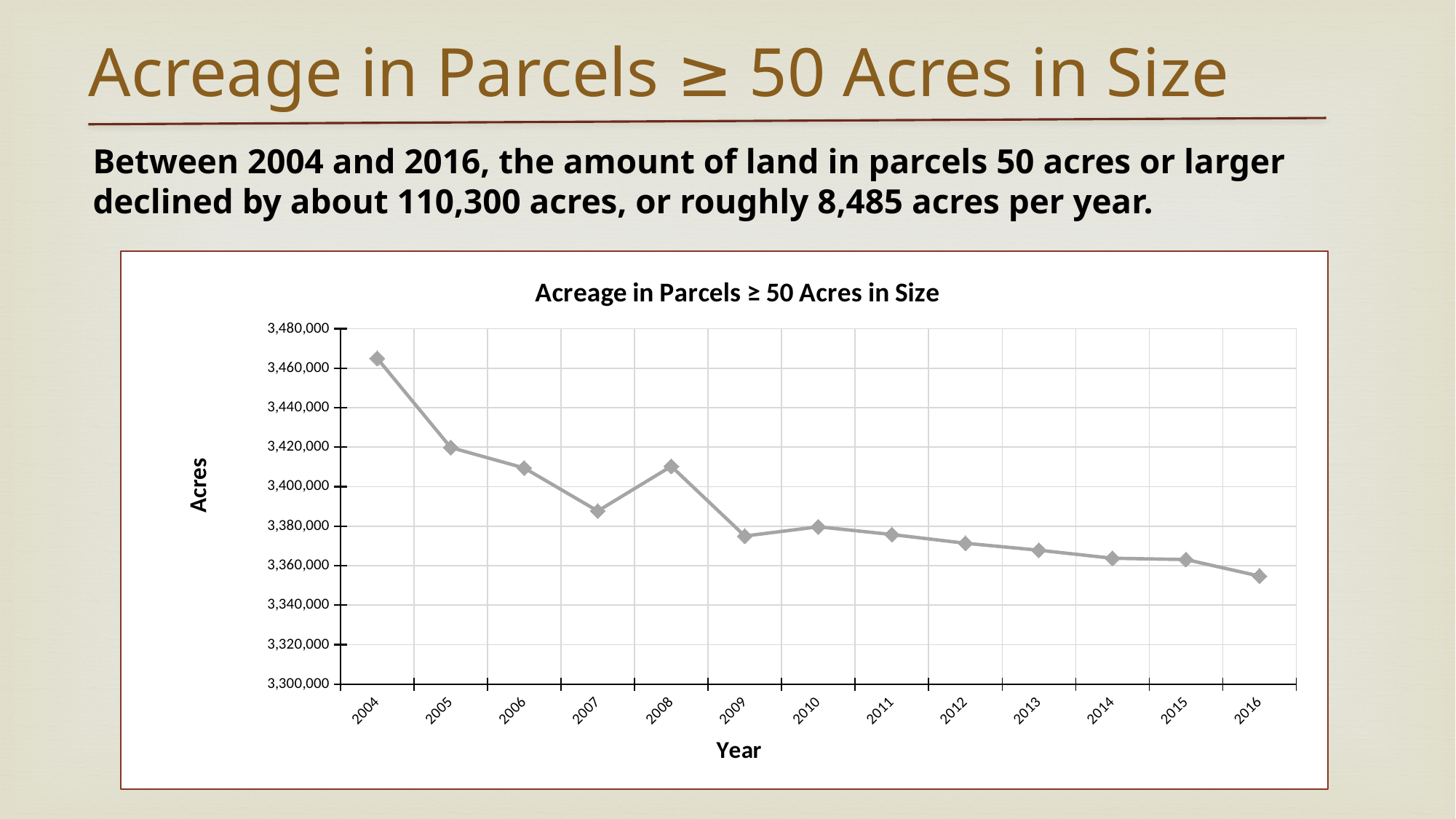
What is the label on the vertical axis of the chart? Acres Which year has the larger value, 2005 or 2009? 2005 Is the value for 2016 greater or less than 3,360,000? less Which year has the lowest acreage in the chart? 2016 Which year has the larger value, 2007 or 2008? 2008 Overall, do the values rise or fall from 2004 to 2016? fall Is the value for 2004 greater or less than 3,460,000? greater Which year has the highest acreage in the chart? 2004 How many years are plotted on the x axis of the chart? 13 Is the value for 2008 greater or less than 3,400,000? greater What kind of chart is shown on the slide? line chart